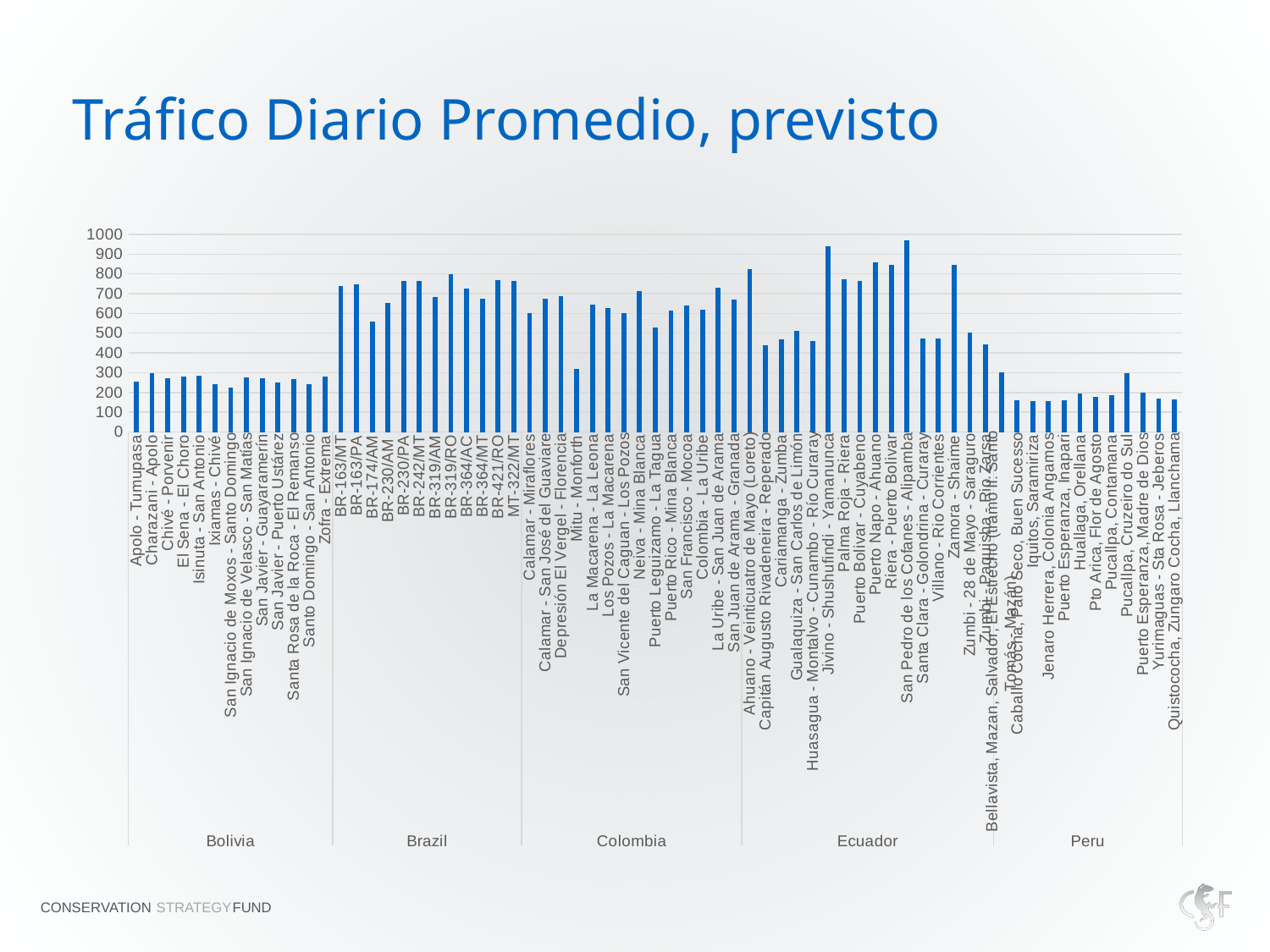
What is the title of the chart? Tráfico Diario Promedio, previsto Which country groups are labelled along the x axis? Bolivia, Brazil, Colombia, Ecuador, Peru Is the value for Zamora - Shaime greater or less than 800? greater Is the value for Mitu - Monforth greater or less than 400? less What kind of chart is shown on the slide? bar chart Is the value for Apolo - Tumupasa greater or less than 300? less How many country groups are shown along the x axis? 5 Which country group contains the tallest bar in the chart? Ecuador Which is larger, the value for Palma Roja - Riera or the value for Zamora - Shaime? Zamora - Shaime Which is larger, the value for BR-163/MT or the value for Apolo - Tumupasa? BR-163/MT